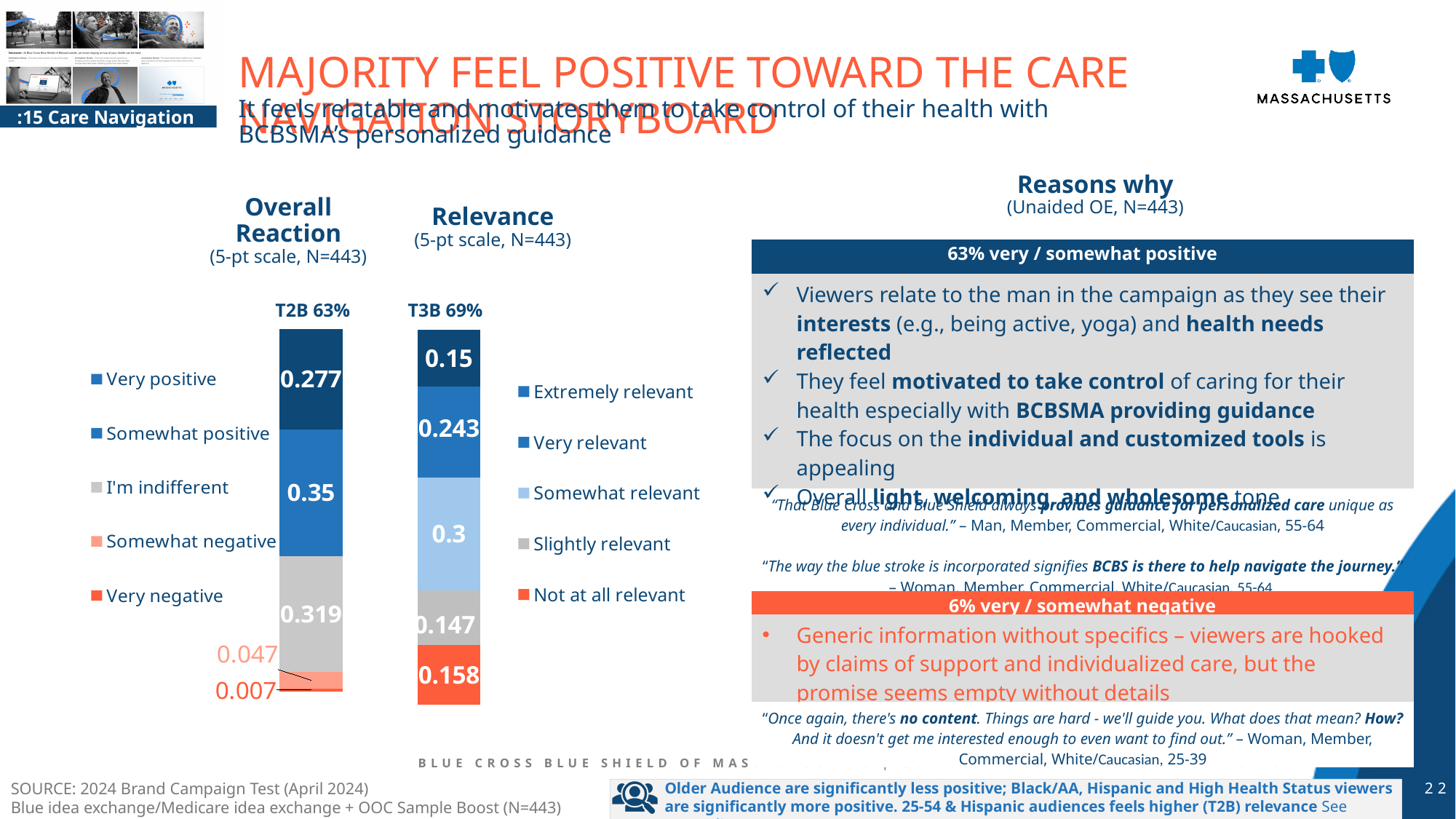
In the Relevance chart, which category has the smallest value? Slightly relevant In the Overall Reaction chart, what is the value for Very negative? 0.007 In the Relevance chart, what is the value for Somewhat relevant? 0.3 In the Relevance chart, which is larger: Very relevant or Extremely relevant? Very relevant In the Overall Reaction chart, which category has the largest value? Somewhat positive What T2B percentage is shown above the Overall Reaction bar? 63% How many series does the legend of the Relevance chart list? 5 In the Overall Reaction chart, what is the difference between Somewhat positive and Very positive? 0.073 In the Overall Reaction chart, what is the value for Somewhat positive? 0.35 What kind of chart is the Overall Reaction chart? Stacked bar chart What T3B percentage is shown above the Relevance bar? 69% In the Relevance chart, what is the value for Not at all relevant? 0.158